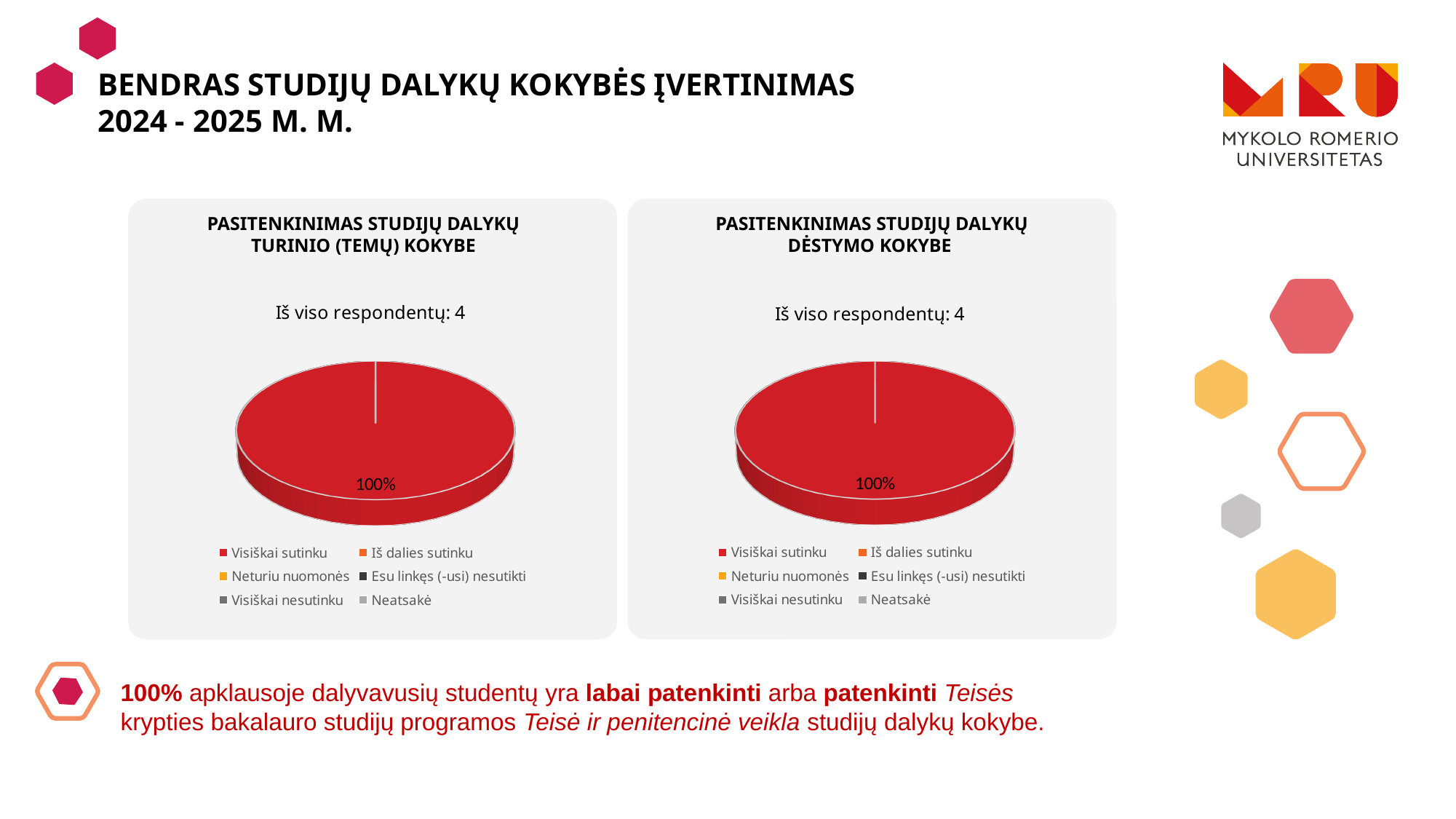
How many respondents are reported for the left chart, 'Pasitenkinimas studijų dalykų turinio (temų) kokybe'? 4 How many entries does the legend of the left chart, 'Pasitenkinimas studijų dalykų turinio (temų) kokybe', list? 6 What is the title of the right chart on the slide? Pasitenkinimas studijų dalykų dėstymo kokybe In the left chart, 'Pasitenkinimas studijų dalykų turinio (temų) kokybe', what share of the pie is labelled? 100% In the left chart, 'Pasitenkinimas studijų dalykų turinio (temų) kokybe', which legend category does the 100% slice belong to? Visiškai sutinku How many entries does the legend of the right chart, 'Pasitenkinimas studijų dalykų dėstymo kokybe', list? 6 What kind of chart is used in the left chart, 'Pasitenkinimas studijų dalykų turinio (temų) kokybe'? Pie chart In the right chart, 'Pasitenkinimas studijų dalykų dėstymo kokybe', which legend category does the 100% slice belong to? Visiškai sutinku How many pie charts are shown on the slide? 2 How many respondents are reported for the right chart, 'Pasitenkinimas studijų dalykų dėstymo kokybe'? 4 In the right chart, 'Pasitenkinimas studijų dalykų dėstymo kokybe', what share of the pie is labelled? 100% In the left chart, 'Pasitenkinimas studijų dalykų turinio (temų) kokybe', what colour is the 'Visiškai sutinku' slice? Red